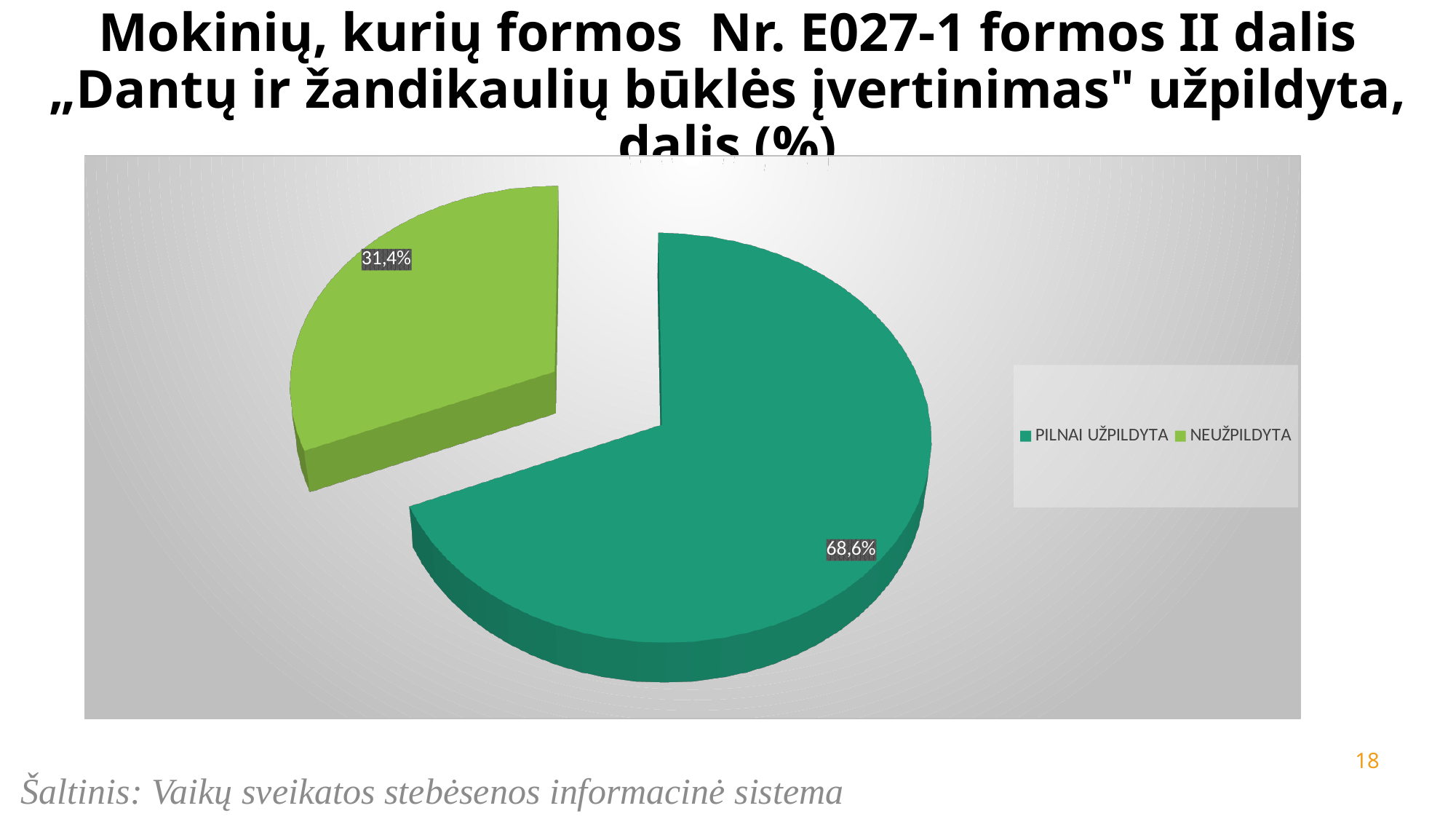
How many entries does the legend list? 2 Which category has the smallest share of the pie? NEUŽPILDYTA What kind of chart is shown on the slide? pie chart What source is cited below the chart? Vaikų sveikatos stebėsenos informacinė sistema What is the value for NEUŽPILDYTA? 31,4% Which is larger, the share for PILNAI UŽPILDYTA or for NEUŽPILDYTA? PILNAI UŽPILDYTA How many slices does the pie chart have? 2 What is the value for PILNAI UŽPILDYTA? 68,6% What is the difference between the PILNAI UŽPILDYTA and NEUŽPILDYTA shares? 37,2% What colour is the PILNAI UŽPILDYTA slice? teal green Which category has the largest share of the pie? PILNAI UŽPILDYTA What share of the pie does the NEUŽPILDYTA slice represent? 31,4%